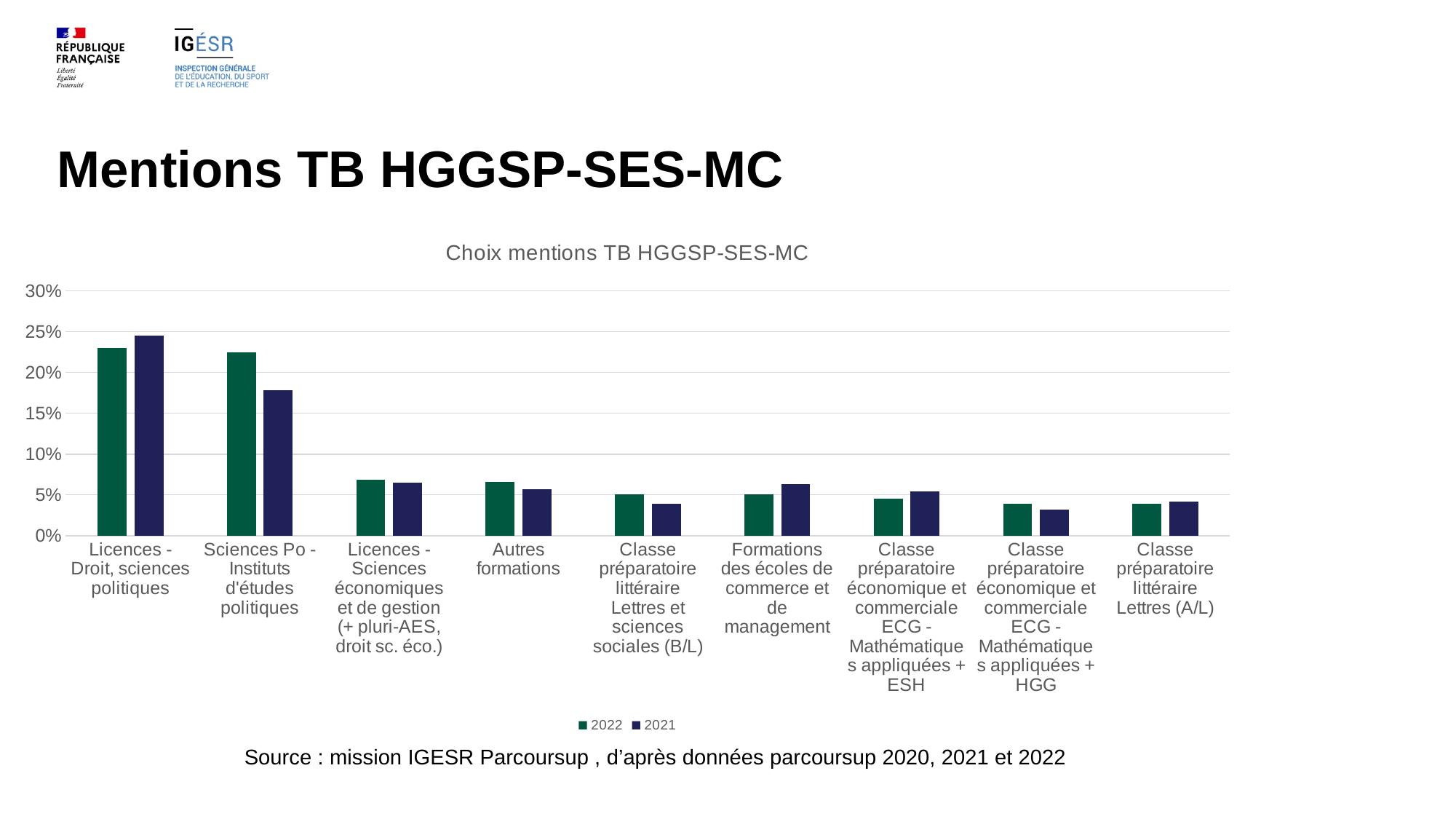
Is the 2021 value for Licences - Droit, sciences politiques greater or less than 20%? greater How many categories are shown on the x axis? 9 For Formations des écoles de commerce et de management, which series has the larger value, 2022 or 2021? 2021 What is the title of the chart? Choix mentions TB HGGSP-SES-MC Is the 2022 value for Autres formations greater or less than 5%? greater Which category has the lowest value for the 2021 series? Classe préparatoire économique et commerciale ECG - Mathématiques appliquées + HGG Which series is shown in dark navy blue in the legend? 2021 For Sciences Po - Instituts d'études politiques, which series has the larger value, 2022 or 2021? 2022 What kind of chart is shown on the slide? bar chart Which category has the highest value for the 2021 series? Licences - Droit, sciences politiques Is the 2021 value for Sciences Po - Instituts d'études politiques greater or less than 20%? less How many series does the legend list? 2